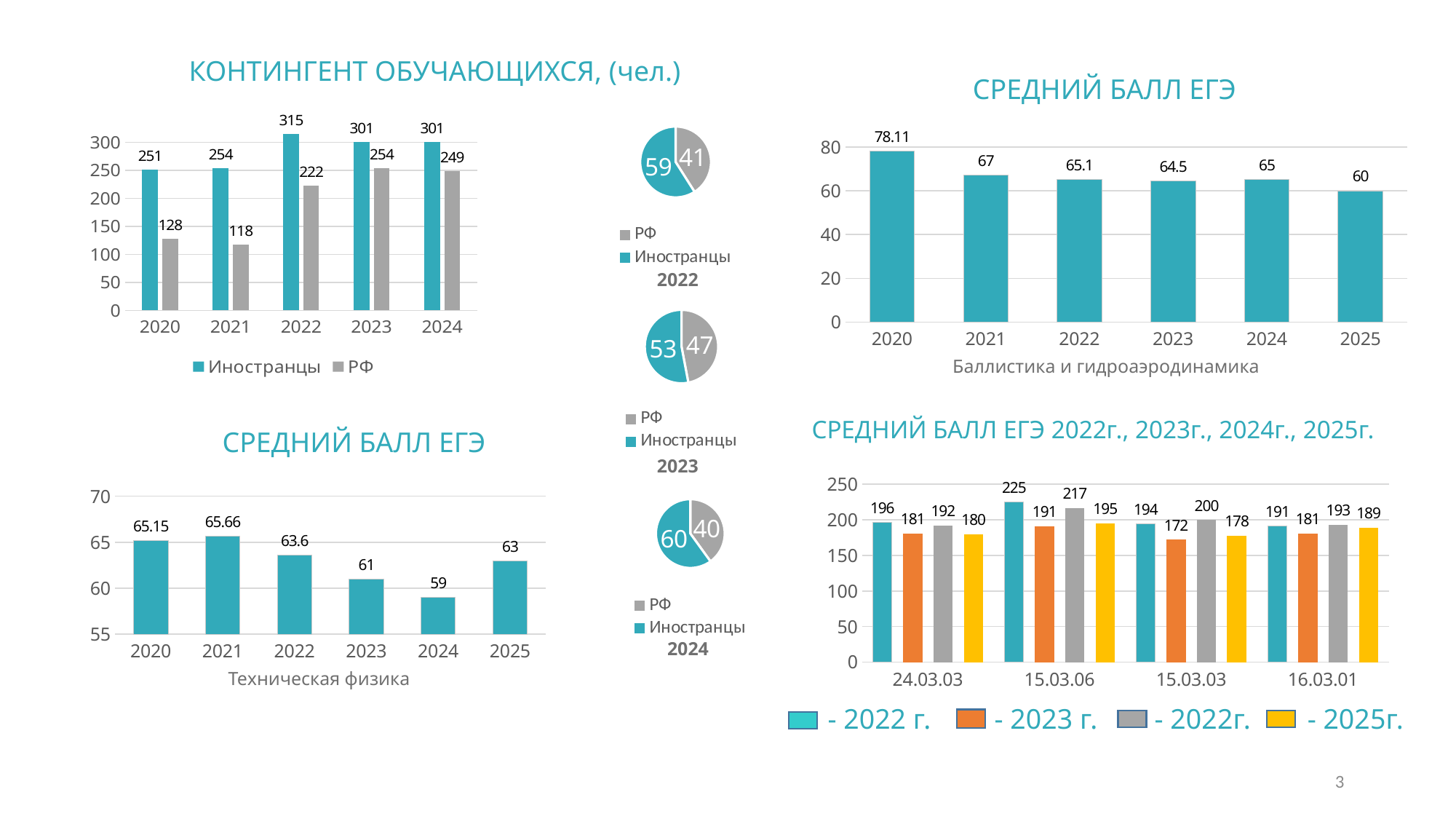
In the 'СРЕДНИЙ БАЛЛ ЕГЭ 2022г., 2023г., 2024г., 2025г.' chart, which is larger for 15.03.06: the 2022 г. (teal) value or the 2025г. value? 2022 г. (teal) In the pie chart labelled 2023, what is the share for Иностранцы? 53 In the 'СРЕДНИЙ БАЛЛ ЕГЭ 2022г., 2023г., 2024г., 2025г.' chart, what is the value of the 2023 г. series for 15.03.03? 172 In the 'КОНТИНГЕНТ ОБУЧАЮЩИХСЯ, (чел.)' chart, how many series does the legend list? 2 In the 'СРЕДНИЙ БАЛЛ ЕГЭ' chart for Техническая физика, how many years are shown on the x axis? 6 In the 'КОНТИНГЕНТ ОБУЧАЮЩИХСЯ, (чел.)' chart, which year has the lowest value for РФ? 2021 In the 'КОНТИНГЕНТ ОБУЧАЮЩИХСЯ, (чел.)' chart, what is the value for Иностранцы in 2022? 315 In the 'КОНТИНГЕНТ ОБУЧАЮЩИХСЯ, (чел.)' chart, what is the difference between Иностранцы and РФ in 2020? 123 In the 'СРЕДНИЙ БАЛЛ ЕГЭ' chart for Техническая физика, which year has the highest value? 2021 In the 'СРЕДНИЙ БАЛЛ ЕГЭ' chart for Баллистика и гидроаэродинамика, what is the value for 2020? 78.11 In the pie chart labelled 2024, what is the share for РФ? 40 In the 'СРЕДНИЙ БАЛЛ ЕГЭ' chart for Баллистика и гидроаэродинамика, which year has the lowest value? 2025